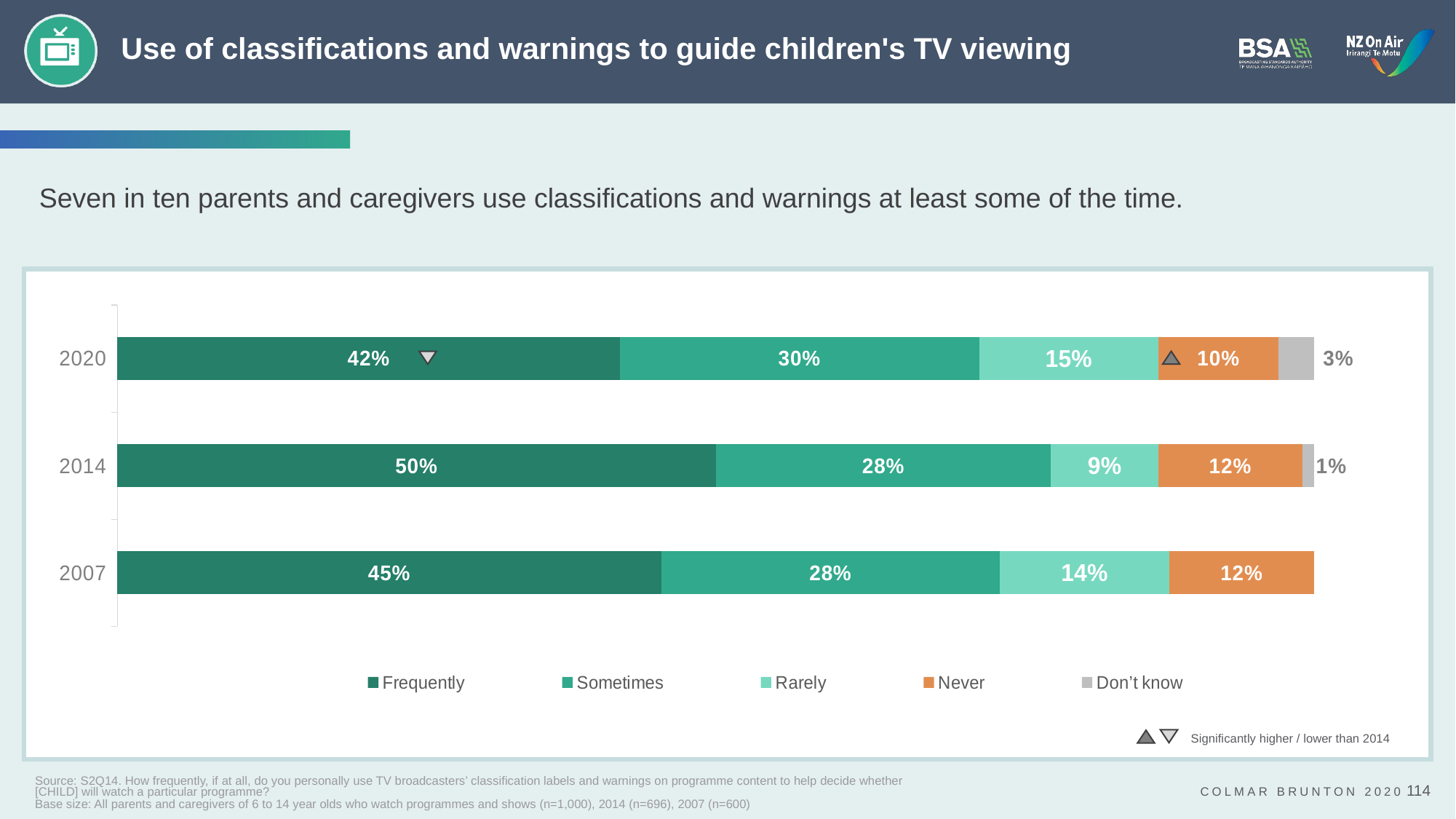
What is the difference between the 'Frequently' values for 2014 and 2020? 8 percentage points What kind of chart is shown on the slide? Stacked bar chart What percentage of parents and caregivers said they use classifications and warnings 'Frequently' in 2020? 42% Which year has the highest 'Frequently' value? 2014 Which year has the lowest 'Rarely' value? 2014 Which series is shown in orange in the chart? Never How many years are shown in the chart? 3 What is the 'Sometimes' value for 2014? 28% What is the 'Don't know' value for 2020? 3% Is the 'Rarely' value larger in 2020 or in 2007? 2020 What is the 'Never' value for 2007? 12% How many series does the legend list? 5